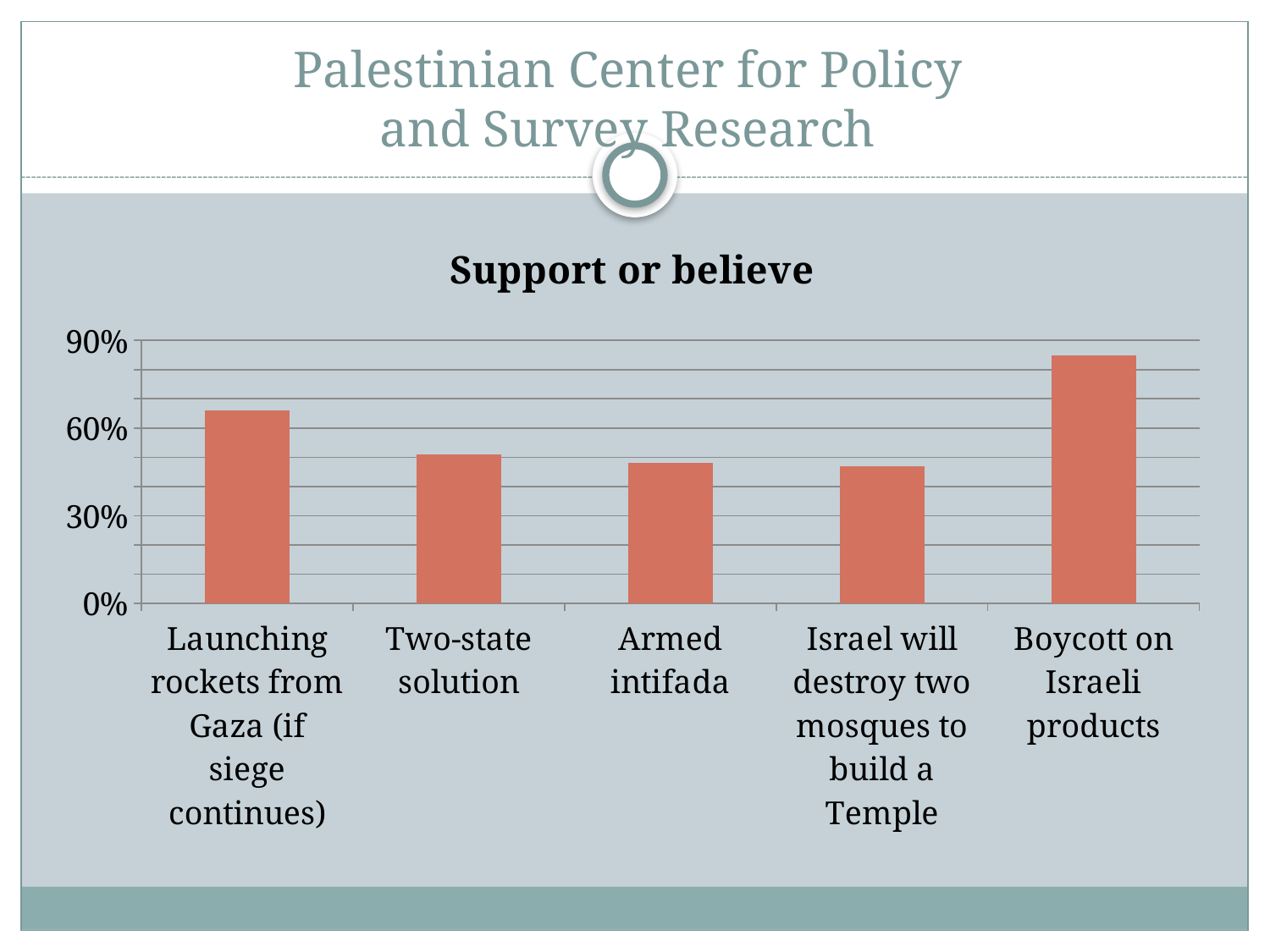
How many categories are shown on the x axis of the chart? 5 Is the value for Launching rockets from Gaza (if siege continues) greater or less than 60%? greater Is the value for Boycott on Israeli products greater or less than 60%? greater Is the value for Boycott on Israeli products greater or less than 90%? less Which is larger: the value for Launching rockets from Gaza (if siege continues) or the value for Two-state solution? Launching rockets from Gaza (if siege continues) What is the title of the chart? Support or believe Which category has the highest value in the chart? Boycott on Israeli products What type of chart is shown on the slide? Bar chart What is the highest value shown on the y axis of the chart? 90% Which is larger: the value for Boycott on Israeli products or the value for Armed intifada? Boycott on Israeli products